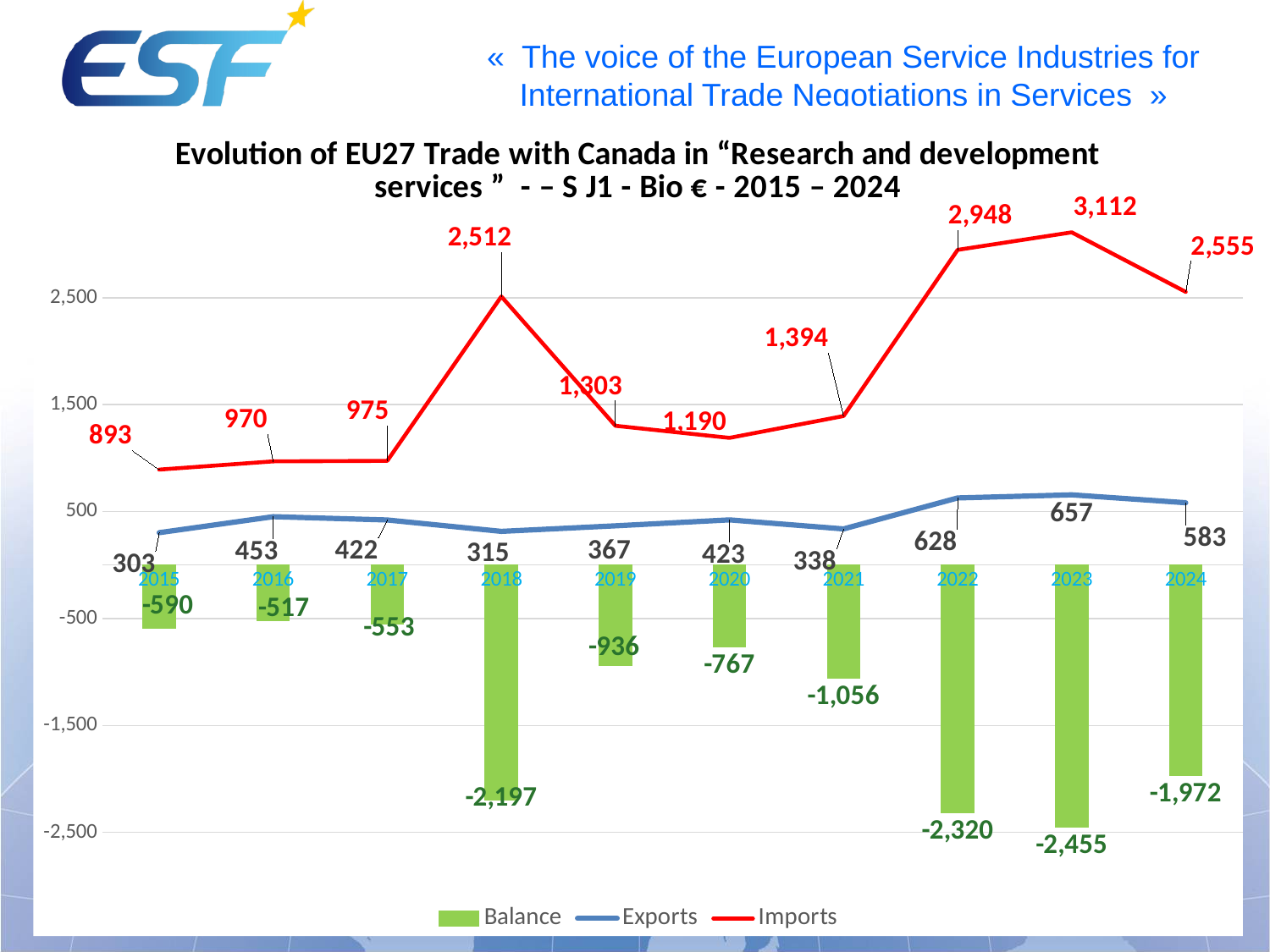
Which is larger, Exports in 2022 or Exports in 2024? Exports in 2022 What is the Balance value for 2021? -1,056 How many years are shown on the x axis? 10 What is the difference between Imports and Exports in 2024? 1,972 In which year are Exports lowest? 2015 What is the value of Imports in 2018? 2,512 In which year are Imports highest? 2023 Which series is plotted as bars rather than a line? Balance What is the value of Exports in 2023? 657 Did Imports rise or fall from 2023 to 2024? fall Is the value of Imports in 2021 greater or less than 1,500? less How many series does the legend list? 3